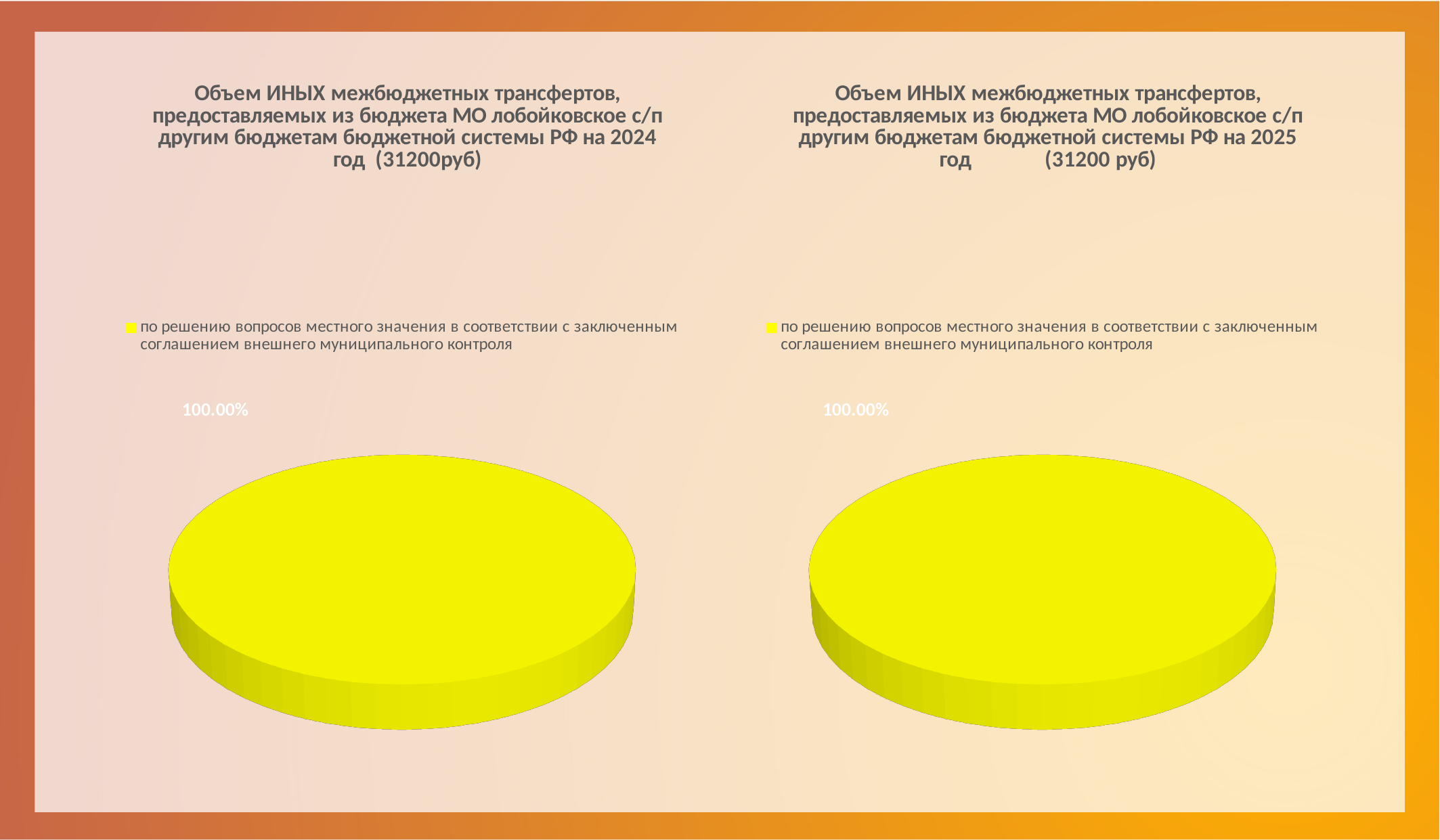
What kind of chart is the left chart (for 2024)? pie chart In the left chart (2024), what share of the pie is labelled for 'по решению вопросов местного значения в соответствии с заключенным соглашением внешнего муниципального контроля'? 100.00% In the right chart (2025), what share of the pie is labelled for 'по решению вопросов местного значения в соответствии с заключенным соглашением внешнего муниципального контроля'? 100.00% Is the share shown in the right chart (2025) greater or less than 50%? greater How many entries does the legend of the left chart (2024) list? 1 What kind of chart is the right chart (for 2025)? pie chart Is the share shown in the left chart (2024) greater or less than 50%? greater What colour is the slice in the right chart (2025)? yellow How many slices does the left chart (2024) contain? 1 What total amount in rubles is stated in the title of the left chart (2024)? 31200руб How many slices does the right chart (2025) contain? 1 How many entries does the legend of the right chart (2025) list? 1